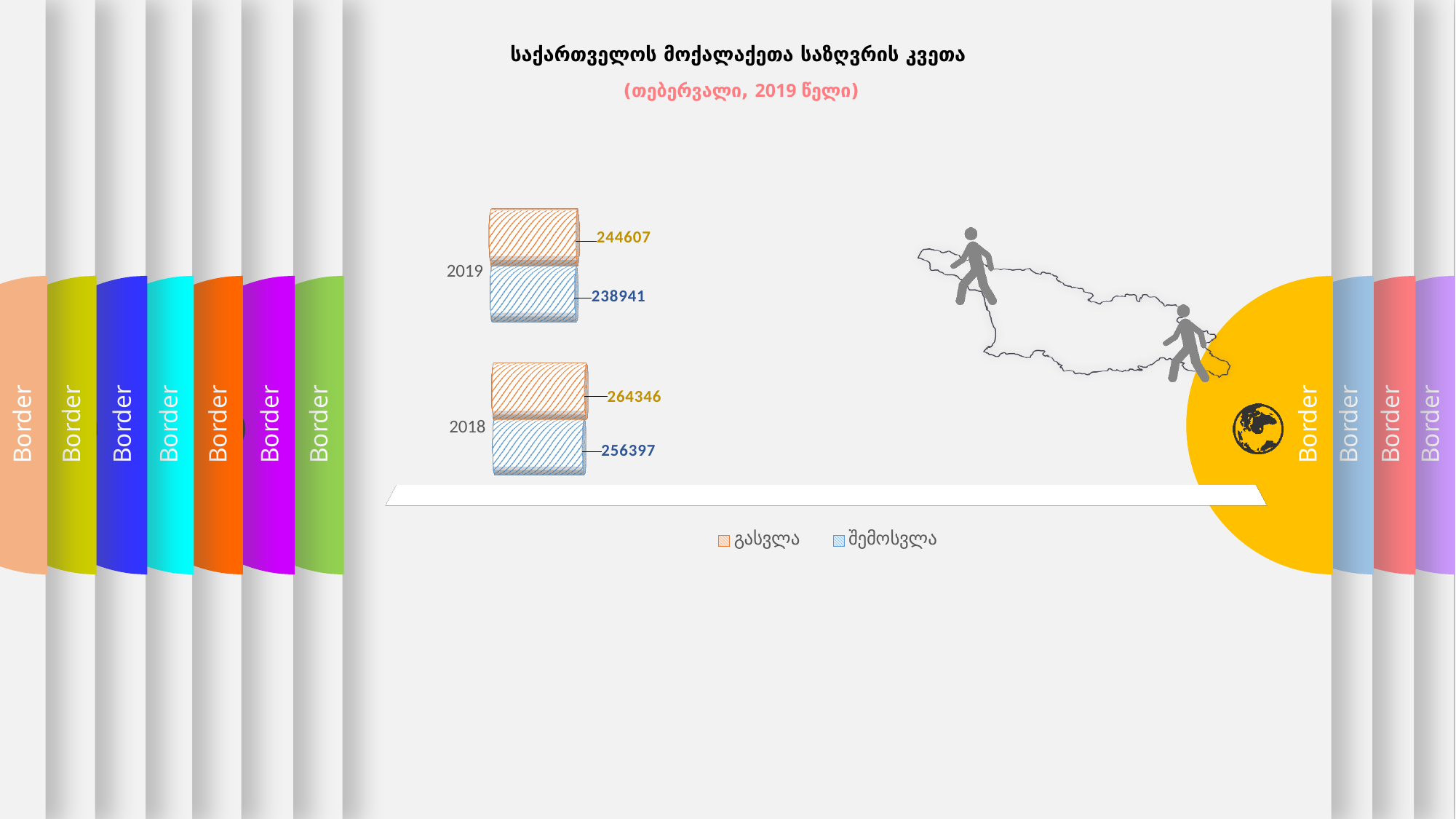
What is the value for გასვლა in 2019? 244607 What is the difference between გასვლა and შემოსვლა in 2019? 5666 How many years are shown in the chart? 2 What is the value for შემოსვლა in 2018? 256397 What is the difference between გასვლა in 2018 and გასვლა in 2019? 19739 In 2018, which is larger: გასვლა or შემოსვლა? გასვლა Which year has the higher value for გასვლა? 2018 Which year has the lower value for შემოსვლა? 2019 What kind of chart is shown on the slide? bar chart What is the value for გასვლა in 2018? 264346 What is the value for შემოსვლა in 2019? 238941 How many series does the legend list? 2